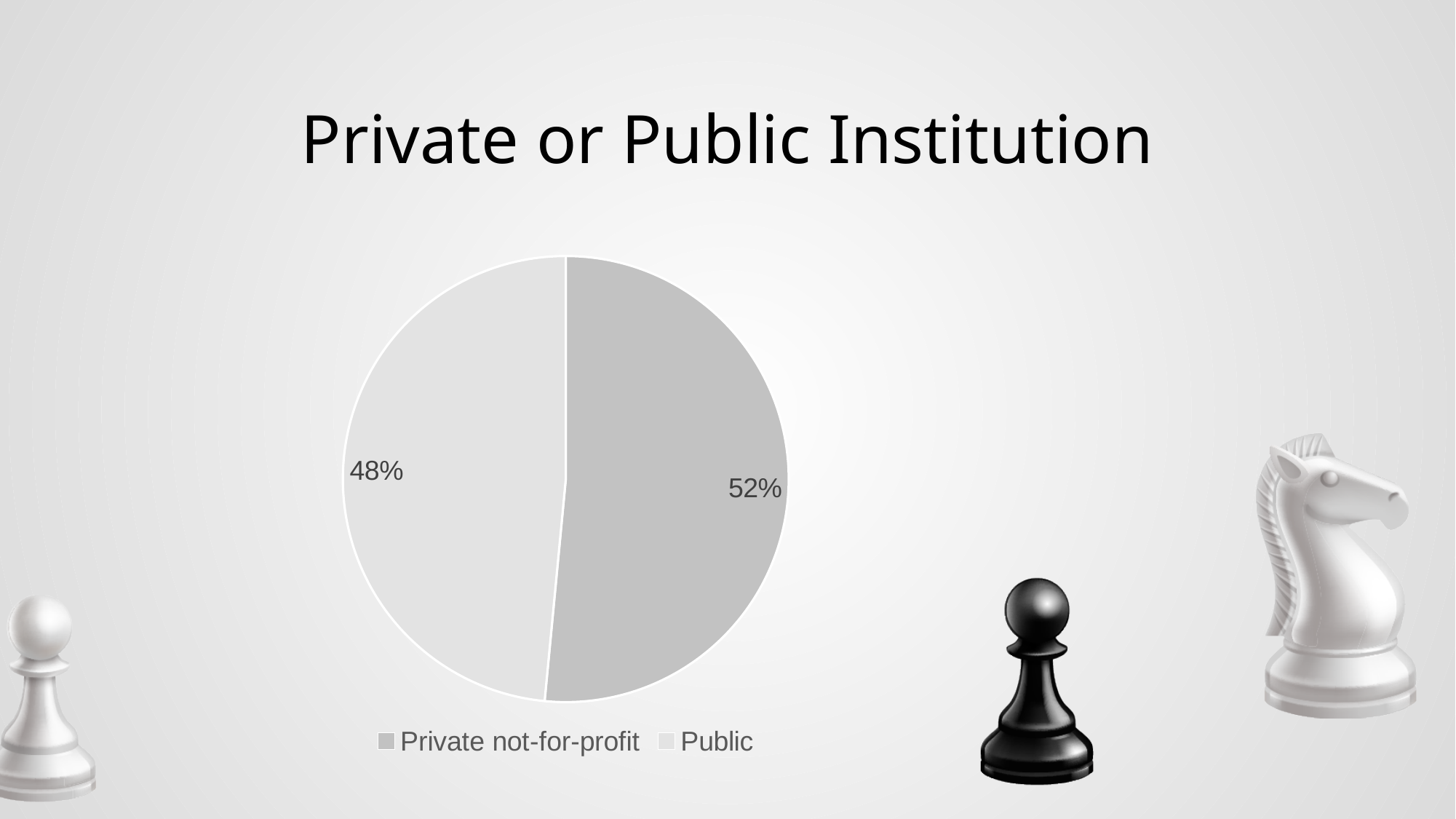
What share of the pie does Public represent? 48% What is the difference in percentage points between the Private not-for-profit and Public slices? 4 Which category has the largest slice of the pie? Private not-for-profit How many entries does the legend list? 2 What is the title of the slide? Private or Public Institution Which is larger, the Private not-for-profit slice or the Public slice? Private not-for-profit What kind of chart is shown on the slide? Pie chart Which category has the smallest slice of the pie? Public How many slices does the pie chart have? 2 Is the Public slice greater or less than 50%? less What share of the pie does Private not-for-profit represent? 52% Which legend entry is shown in the lighter gray colour? Public